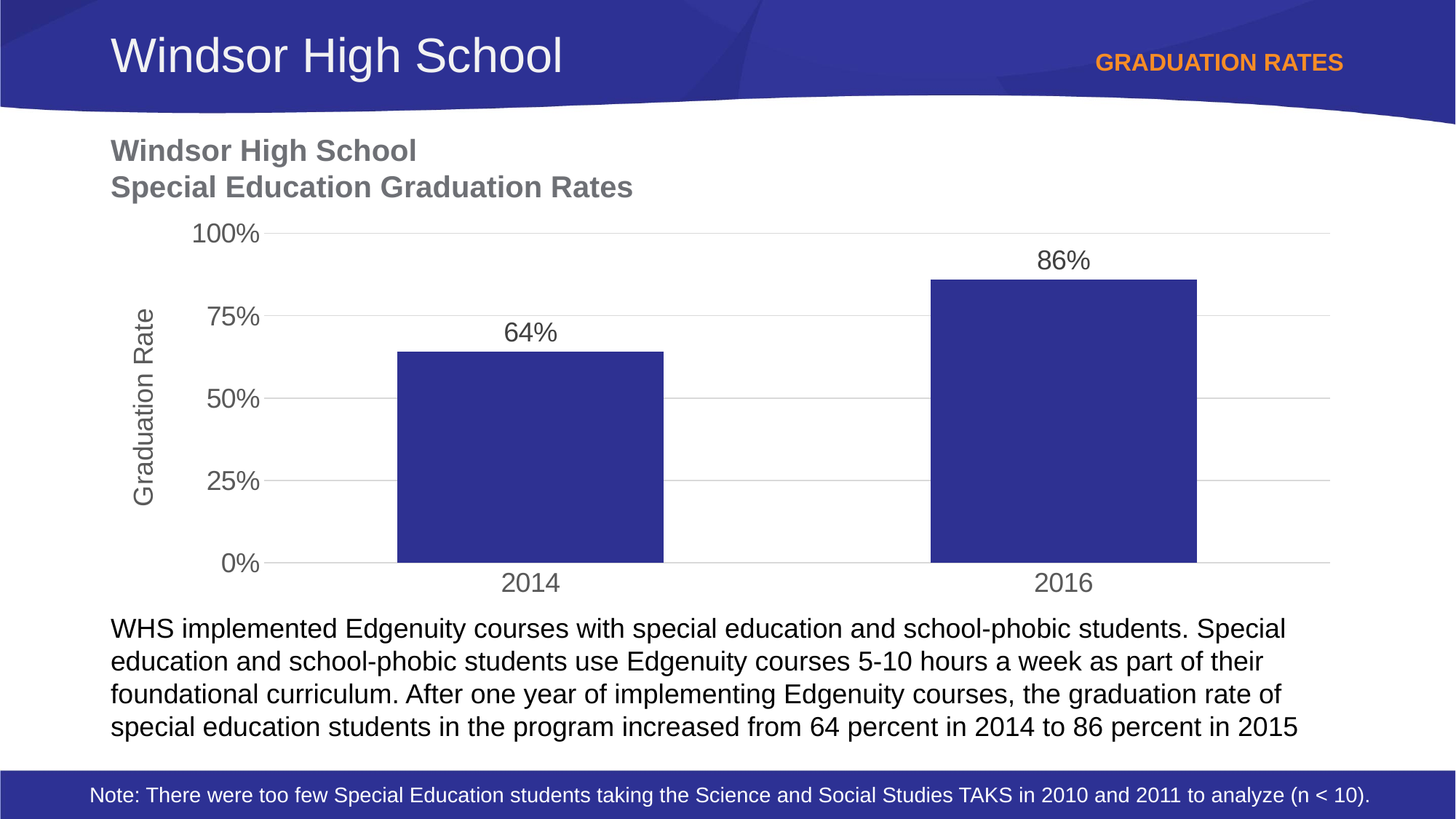
How many years are shown in the chart? 2 Which year has a larger graduation rate, 2014 or 2016? 2016 Which year has the highest graduation rate? 2016 What kind of chart is shown on the slide? bar chart What is the graduation rate for 2016? 86% Does the graduation rate rise or fall from 2014 to 2016? rise What is the graduation rate for 2014? 64% Is the graduation rate for 2016 greater or less than 75%? greater Which year has the lowest graduation rate? 2014 What is the difference in graduation rate between 2016 and 2014? 22% What is the label on the vertical axis of the chart? Graduation Rate Is the graduation rate for 2014 greater or less than 75%? less